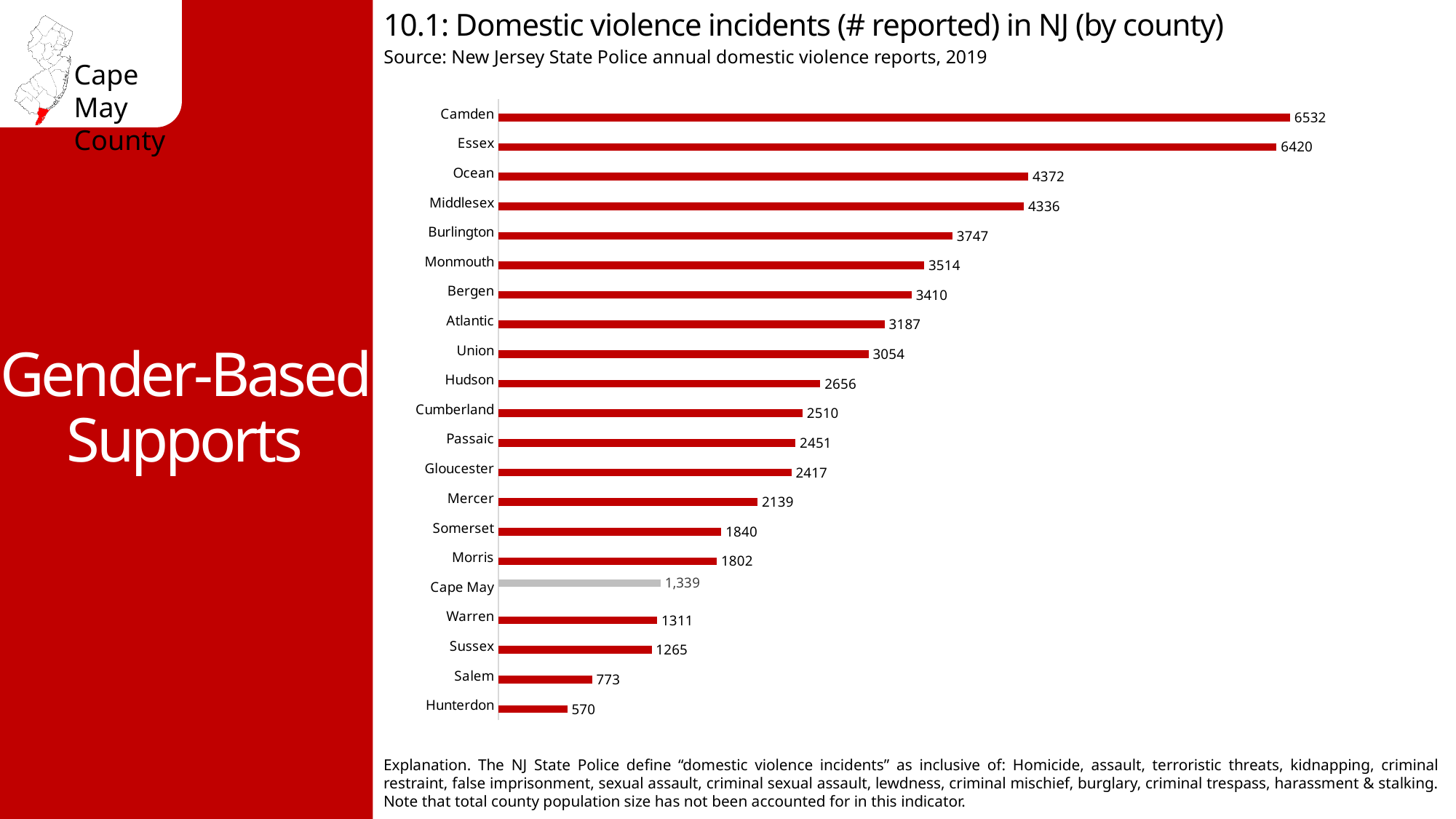
What is the difference between the values for Cape May and Warren? 28 What kind of chart is shown on the slide? Bar chart Which has a higher value, Ocean or Middlesex? Ocean Which county has the highest number of reported domestic violence incidents? Camden What is the difference between the values for Camden and Essex? 112 What is the number of domestic violence incidents reported for Camden? 6532 How many counties are shown in the chart? 21 Which county has the lowest number of reported domestic violence incidents? Hunterdon What is the number of domestic violence incidents reported for Bergen? 3410 What is the number of domestic violence incidents reported for Cape May? 1,339 Which has a higher value, Salem or Sussex? Sussex Which county's bar is coloured grey instead of red? Cape May